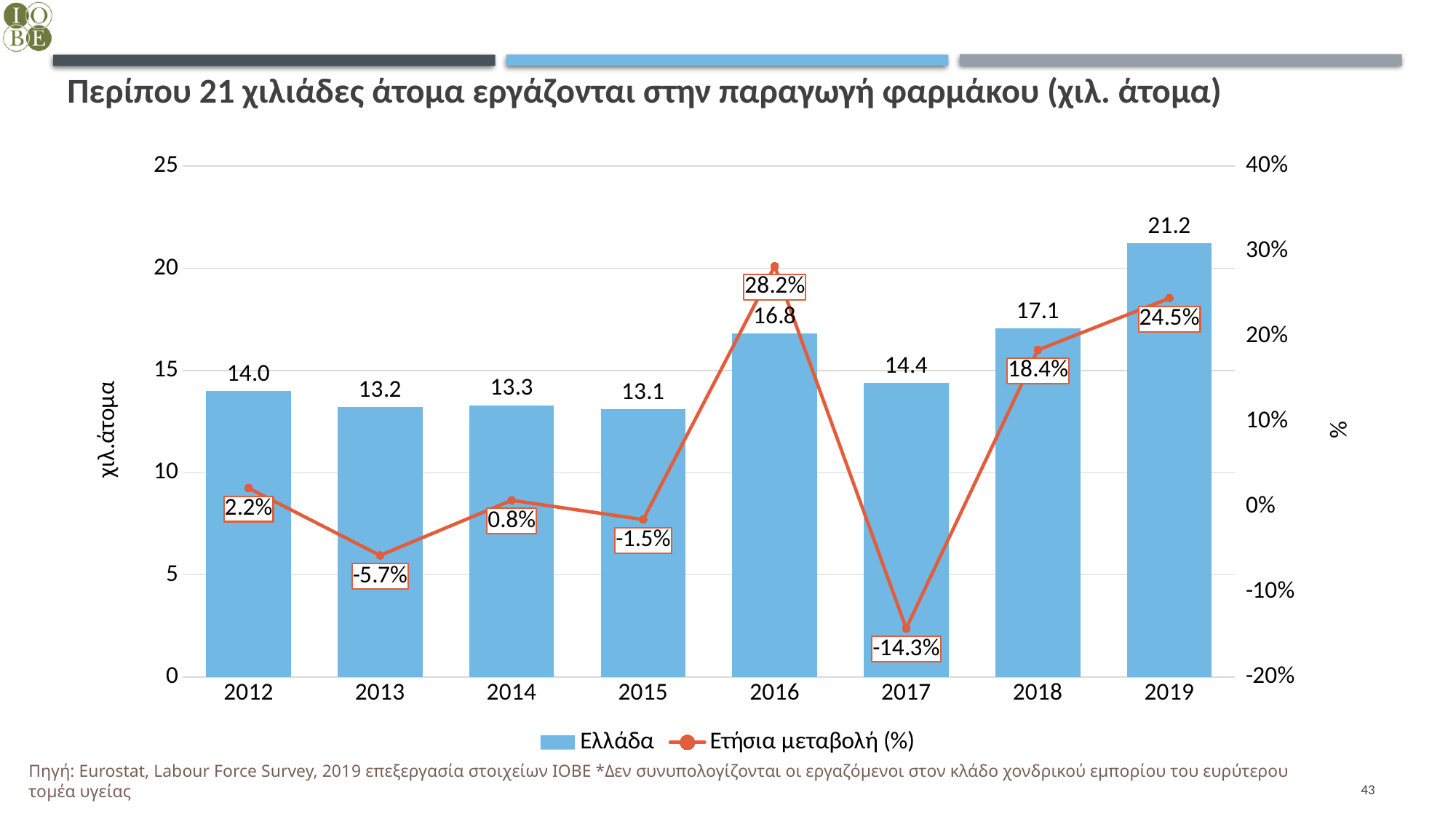
What kind of chart is shown on the slide? Combined bar and line chart What is the value of the Ελλάδα bar for 2015? 13.1 What is the value of the Ελλάδα bar for 2019? 21.2 How many series does the legend list? 2 Which year has the lowest Ετήσια μεταβολή (%) value? 2017 Which year has the highest Ελλάδα bar value? 2019 Do the Ελλάδα bar values rise or fall from 2017 to 2019? rise How many years are shown on the x axis of the chart? 8 Which is larger, the Ελλάδα bar value for 2016 or for 2017? 2016 What is the difference between the Ελλάδα bar values for 2019 and 2018? 4.1 Is the Ελλάδα bar value for 2019 greater or less than 20? greater What is the Ετήσια μεταβολή (%) value shown for 2016? 28.2%